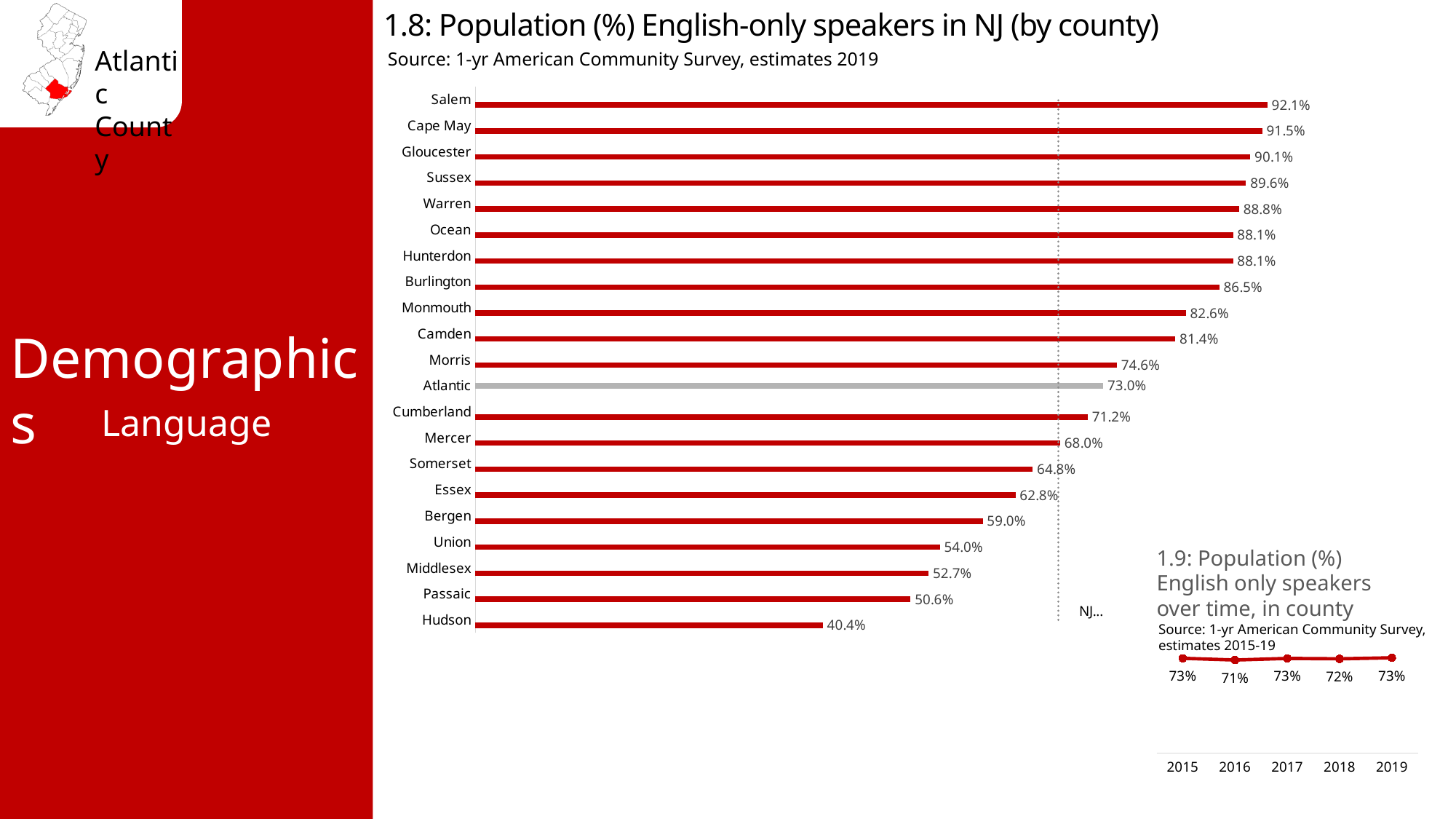
In chart 1.8, what is the difference between the values for Salem and Hudson? 51.7% In chart 1.9, how many years are plotted? 5 What kind of chart is chart 1.8? Bar chart In chart 1.8, which county's bar is shown in grey instead of red? Atlantic In chart 1.8, what is the value for Atlantic? 73.0% What kind of chart is chart 1.9? Line chart In chart 1.8, how many counties are plotted? 21 In chart 1.9, what is the value for 2016? 71% In chart 1.8, which is larger, the value for Camden or the value for Morris? Camden In chart 1.8, which county has the highest percentage of English-only speakers? Salem In chart 1.8, what is the value for Hudson? 40.4% In chart 1.8, which county has the lowest percentage of English-only speakers? Hudson